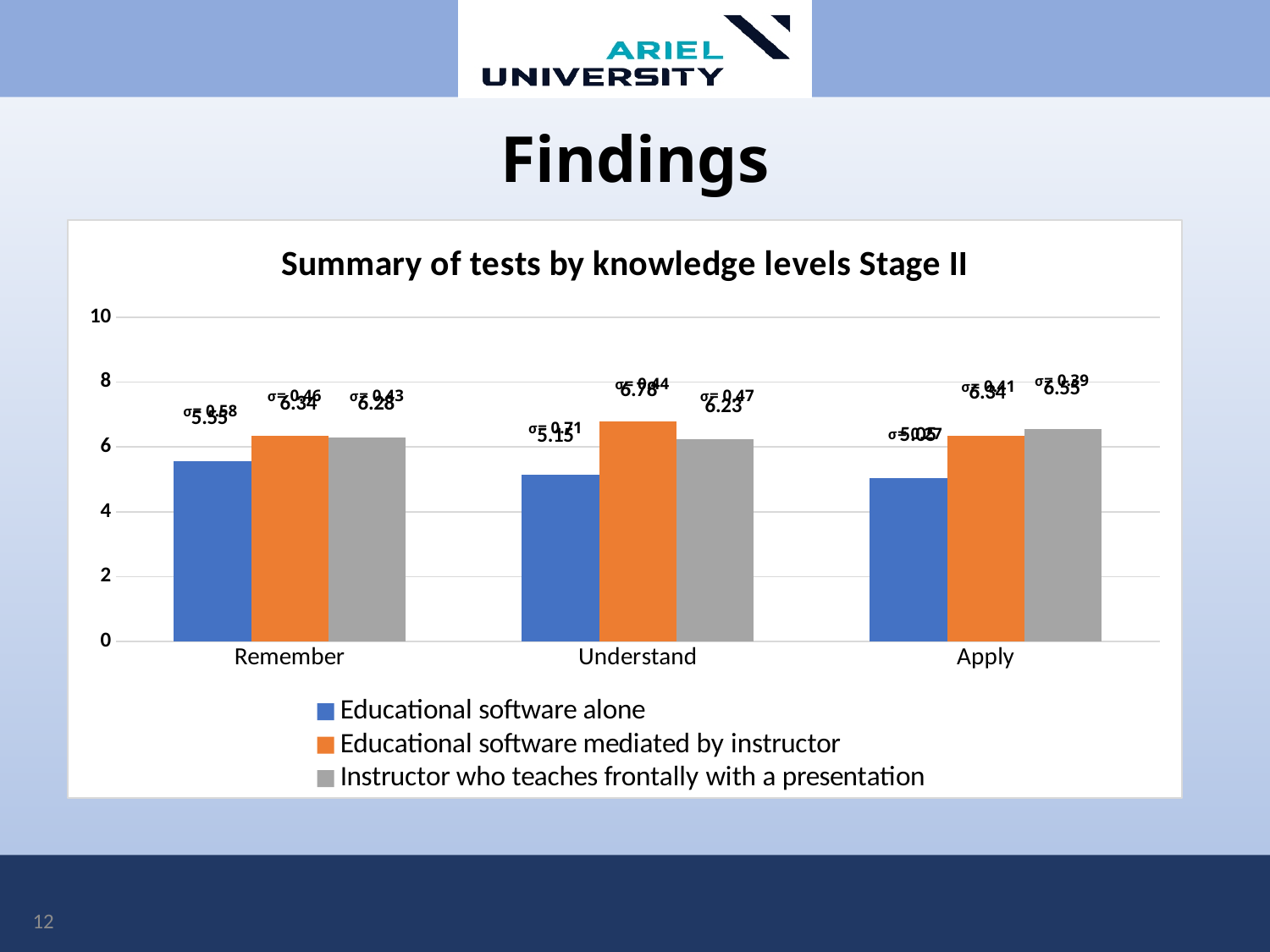
Is the value for Educational software alone in the Apply category greater or less than 6? less How many knowledge-level categories are shown on the x axis? 3 Which series has the highest value in the Understand category? Educational software mediated by instructor In the Understand category, what is the difference between Educational software mediated by instructor and Instructor who teaches frontally with a presentation? 0.55 What type of chart is shown on the slide? Bar chart How many series does the legend list? 3 What is the value for Instructor who teaches frontally with a presentation in the Apply category? 6.55 Which series is shown in orange? Educational software mediated by instructor What is the title of the chart? Summary of tests by knowledge levels Stage II What is the value for Educational software alone in the Understand category? 5.15 Which series has the lowest value in the Remember category? Educational software alone What is the value for Educational software mediated by instructor in the Understand category? 6.78